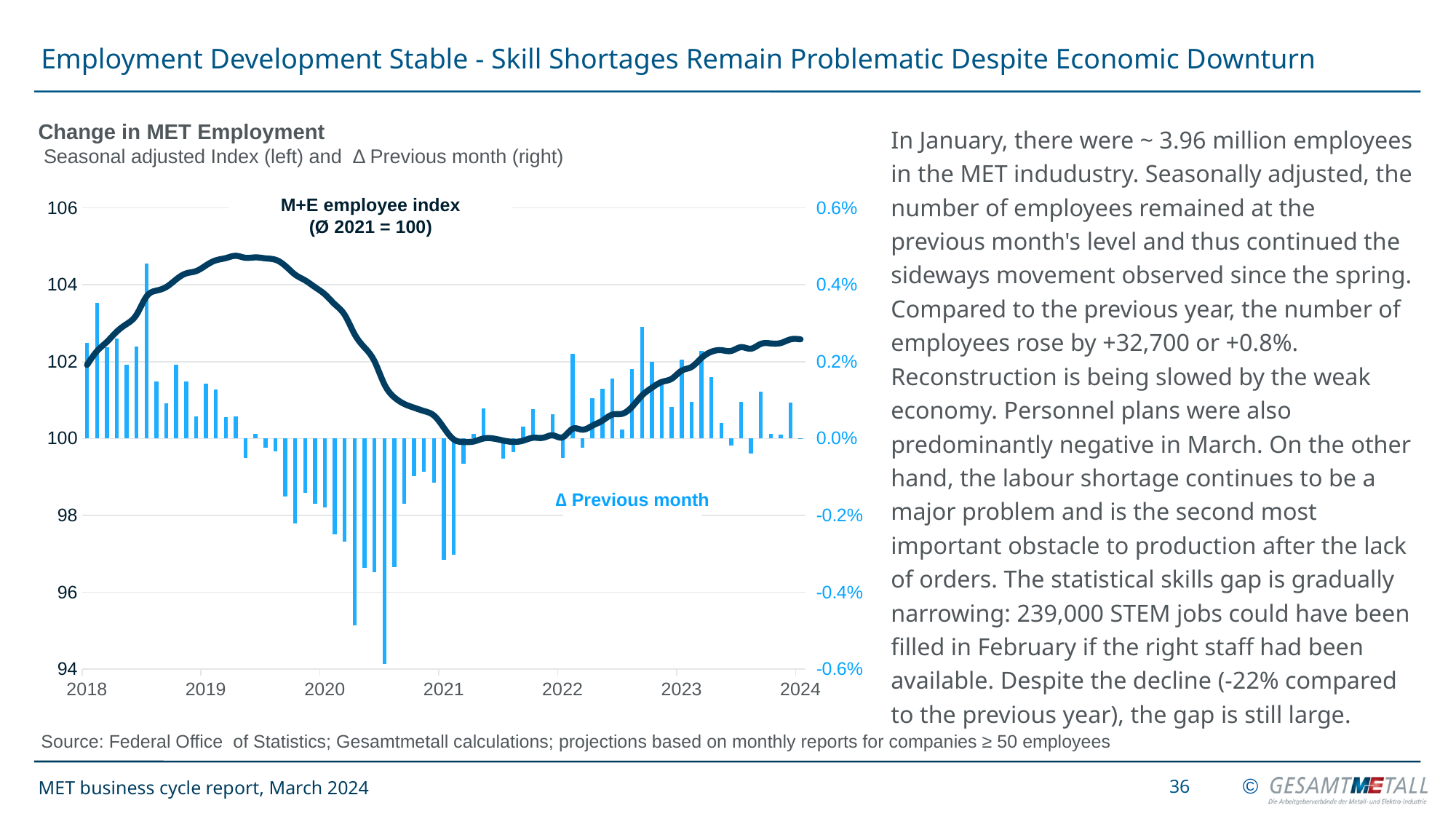
What is the title of the chart? Change in MET Employment Does the M+E employee index rise or fall between 2021 and 2024? rise How many data series are plotted in the chart? 2 In which year does the M+E employee index line reach its lowest point? 2021 Does the M+E employee index rise or fall between 2019 and 2021? fall What base period is the M+E employee index set to 100? Ø 2021 = 100 What kind of chart is shown on the slide? A combined line and bar chart Is the M+E employee index at the start of 2021 greater or less than 102? less Is the M+E employee index higher at the start of 2019 or at the start of 2024? 2019 How many year labels are shown on the x axis? 7 In which year does the M+E employee index line reach its highest point? 2019 Is the lowest Δ Previous month bar greater or less than -0.4%? less